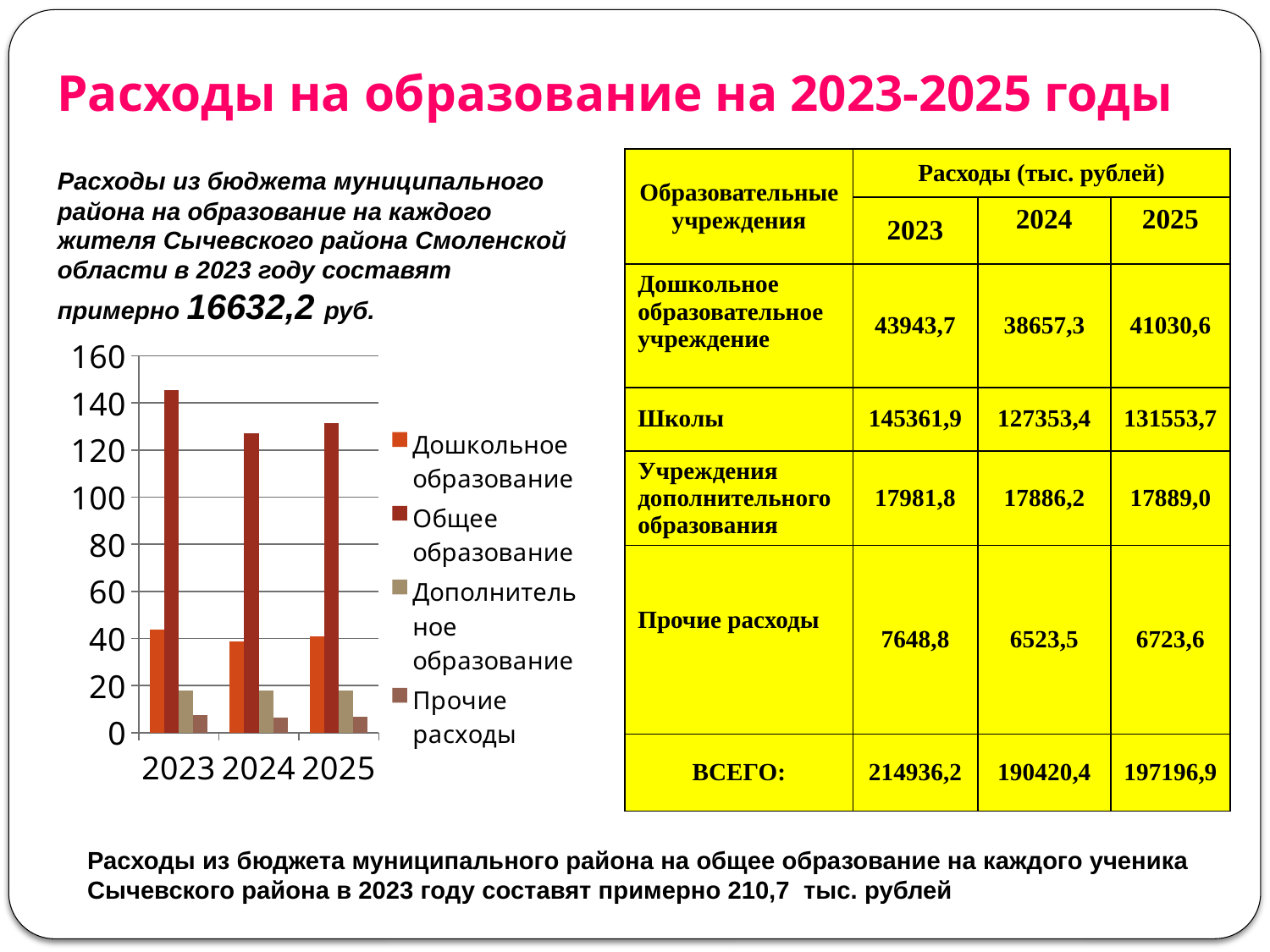
How many series does the chart legend list? 4 In which year is the bar for Общее образование the highest? 2023 Which series has the shortest bars in every year of the chart? Прочие расходы Is the value for Общее образование in 2023 greater or less than 140? greater How many years are shown on the x axis of the chart? 3 Is the value for Прочие расходы in 2023 greater or less than 20? less Which is larger in 2025: the bar for Дошкольное образование or the bar for Общее образование? Общее образование Is the value for Общее образование in 2024 greater or less than 140? less Which series has the tallest bars in every year of the chart? Общее образование Does the bar for Общее образование rise or fall from 2023 to 2024? fall What kind of chart is shown on the slide? bar chart What is the highest value shown on the chart's vertical axis? 160